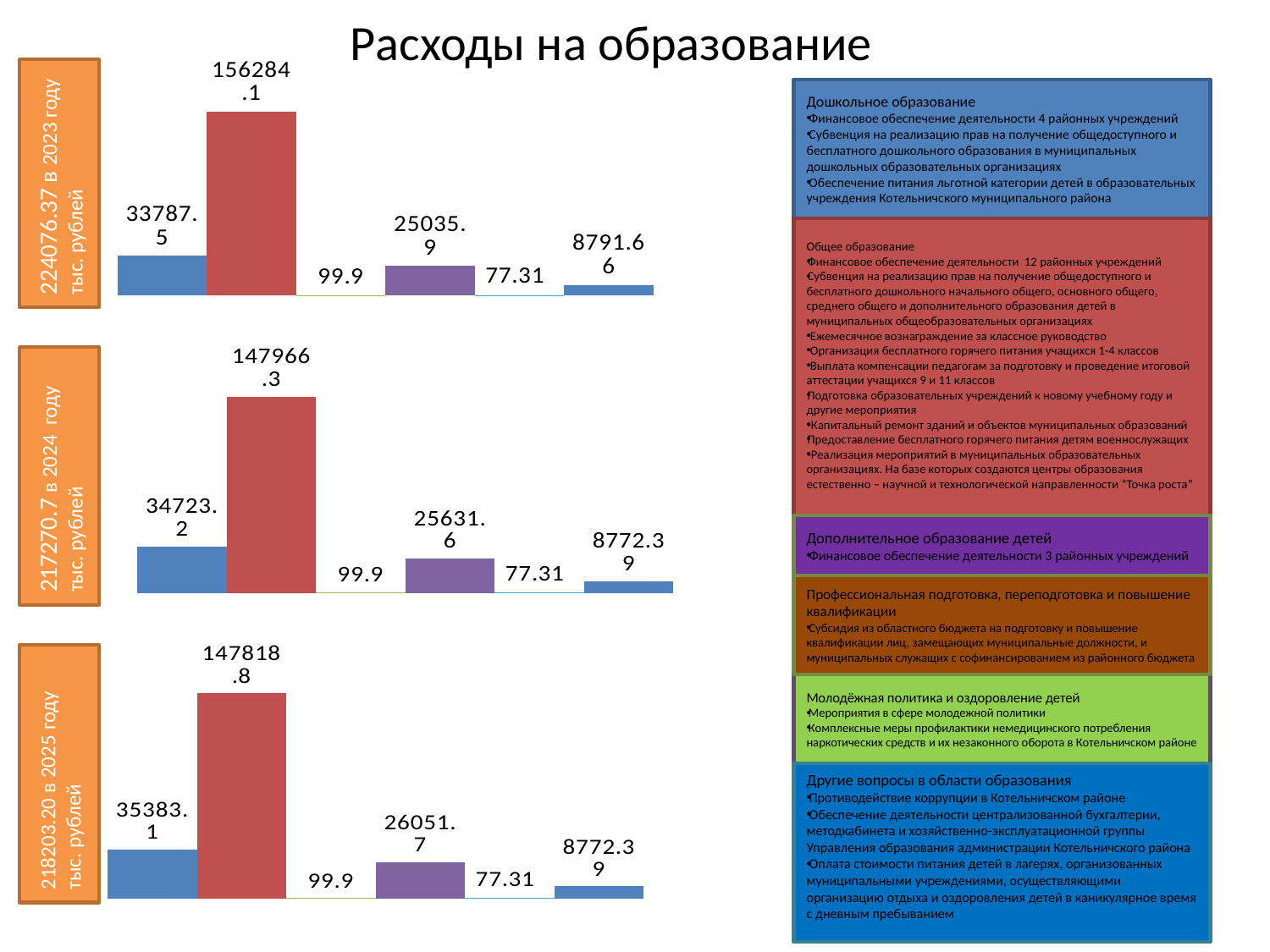
In the 2024 chart (middle chart), what is the value of the first (blue) bar on the left? 34723.2 Which is larger: the red bar in the 2024 chart (147966.3) or the red bar in the 2025 chart (147818.8)? 2024 chart (147966.3) In the 2024 chart (middle chart), what is the largest labelled value? 147966.3 How many bars are plotted in the 2024 chart (middle chart)? 6 In the 2023 chart (top chart), what is the smallest labelled value? 77.31 What total amount in thousand rubles is shown in the orange label for the 2025 chart (bottom chart)? 218203.20 In the 2023 chart (top chart), what is the difference between the red bar (156284.1) and the blue bar on the left (33787.5)? 122496.6 In the 2023 chart (top chart), what is the value of the tallest (red) bar? 156284.1 What type of chart is used for the 2023 data (top chart)? bar chart What is the title of the slide containing the charts? Расходы на образование In the 2025 chart (bottom chart), what is the value of the last bar on the right? 8772.39 In the 2025 chart (bottom chart), what is the value of the purple bar? 26051.7